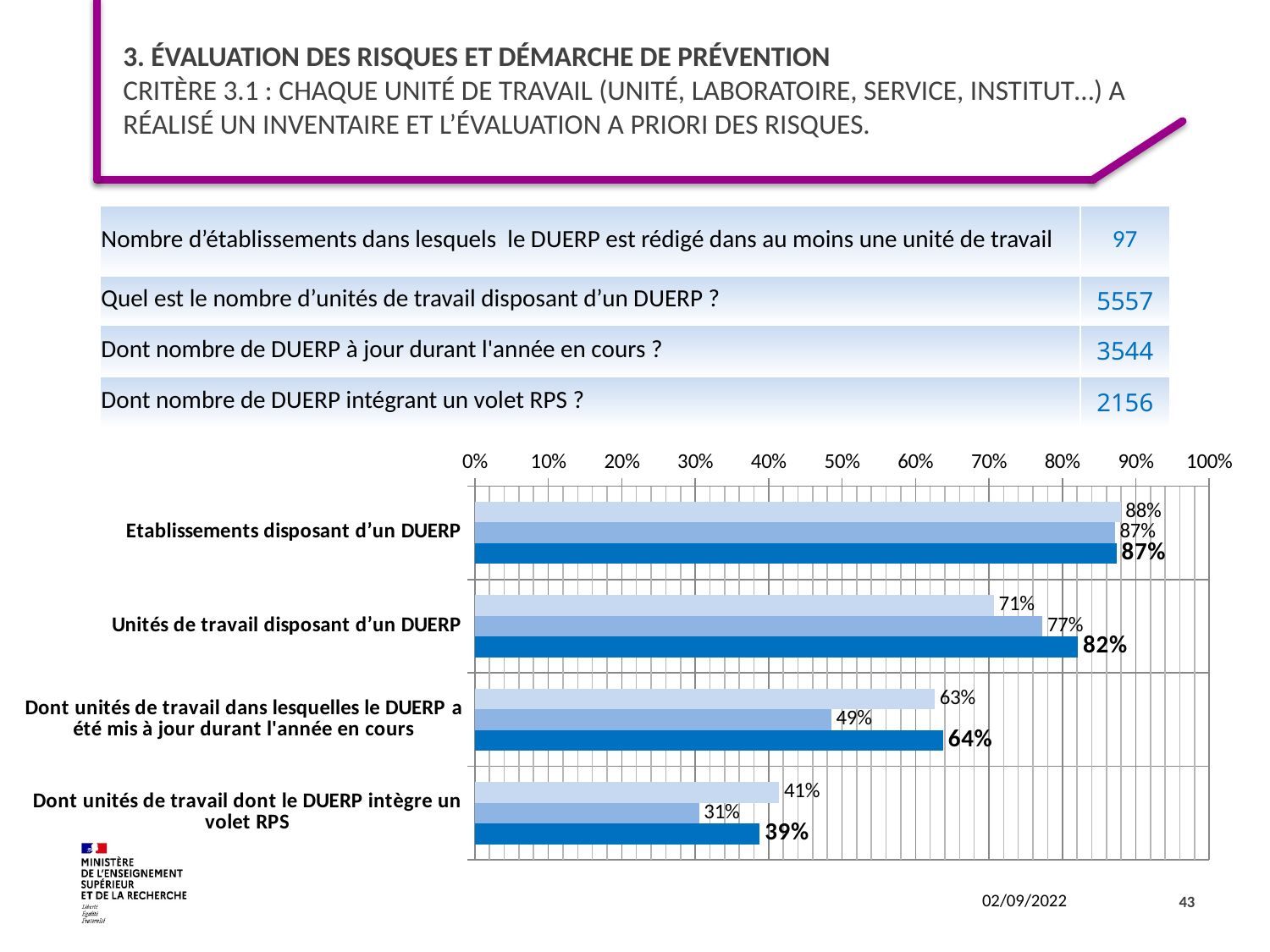
What kind of chart is shown on the slide? bar chart How many bars are shown for each category in the chart? 3 What is the value of the medium blue (middle) bar for 'Dont unités de travail dans lesquelles le DUERP a été mis à jour durant l'année en cours'? 49% How many categories does the bar chart show? 4 What is the value of the dark blue (bottom) bar for 'Dont unités de travail dont le DUERP intègre un volet RPS'? 39% What is the value of the dark blue (bottom) bar for 'Etablissements disposant d'un DUERP'? 87% For 'Unités de travail disposant d'un DUERP', which is larger: the light blue (top) bar or the dark blue (bottom) bar? the dark blue (bottom) bar Which category has the highest value for the light blue (top) bar? Etablissements disposant d'un DUERP What is the difference between the dark blue (bottom) bar and the medium blue (middle) bar for 'Dont unités de travail dans lesquelles le DUERP a été mis à jour durant l'année en cours'? 15% Which category has the lowest value for the dark blue (bottom) bar? Dont unités de travail dont le DUERP intègre un volet RPS Do the values of the dark blue (bottom) bars rise or fall going down the categories from top to bottom? fall What is the value of the light blue (top) bar for 'Unités de travail disposant d'un DUERP'? 71%